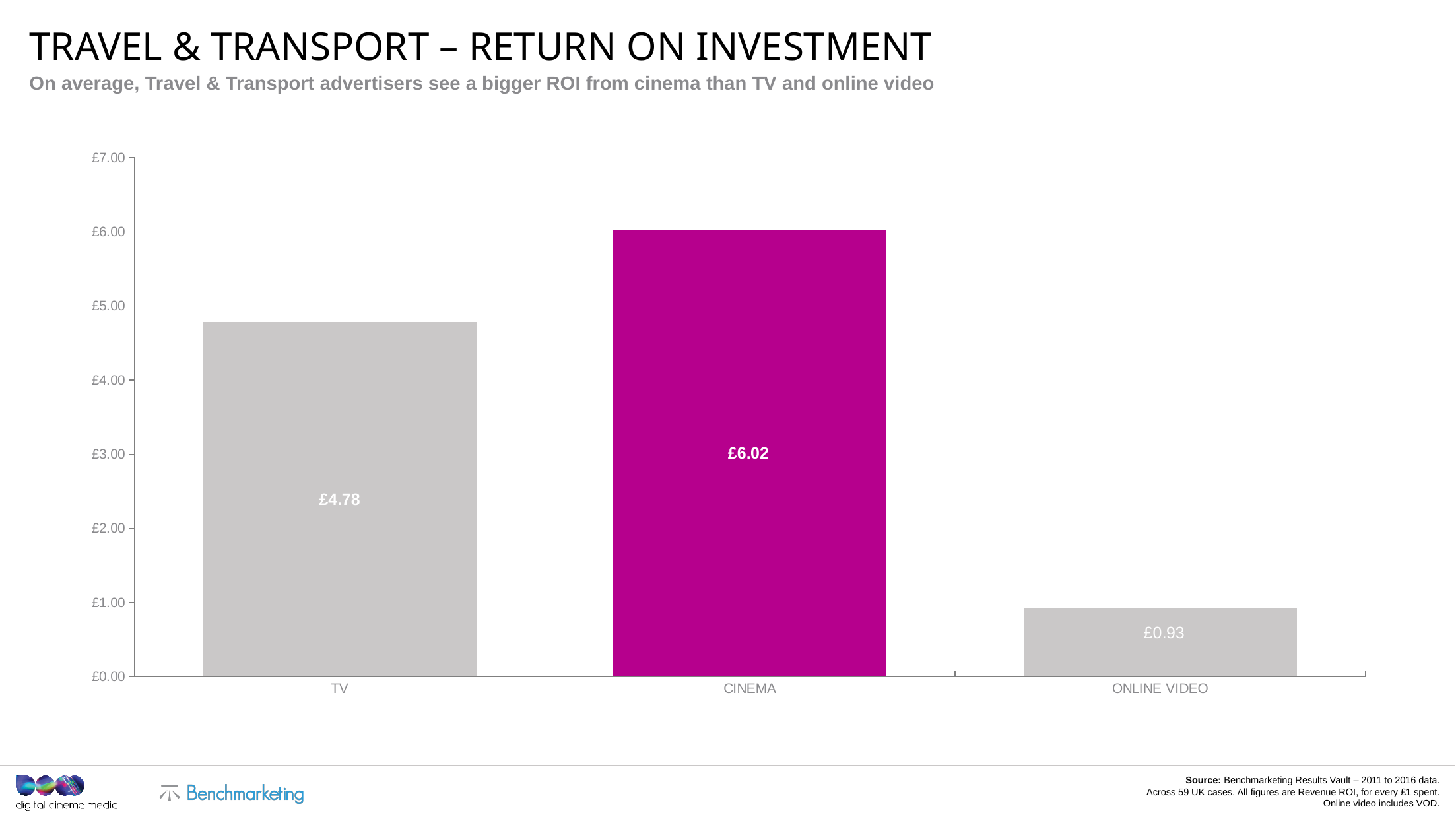
Which has a larger ROI, TV or Online Video? TV Which bar is highlighted in magenta rather than grey? Cinema How many categories are shown on the chart? 3 What is the difference between the ROI for Cinema and the ROI for TV? £1.24 What kind of chart is shown on the slide? Bar chart Which category has the highest ROI? Cinema What is the ROI value for Cinema? £6.02 What is the ROI value for Online Video? £0.93 What is the difference between the ROI for TV and the ROI for Online Video? £3.85 What is the ROI value for TV? £4.78 Is the value for Cinema greater or less than £5.00? greater Which category has the lowest ROI? Online Video